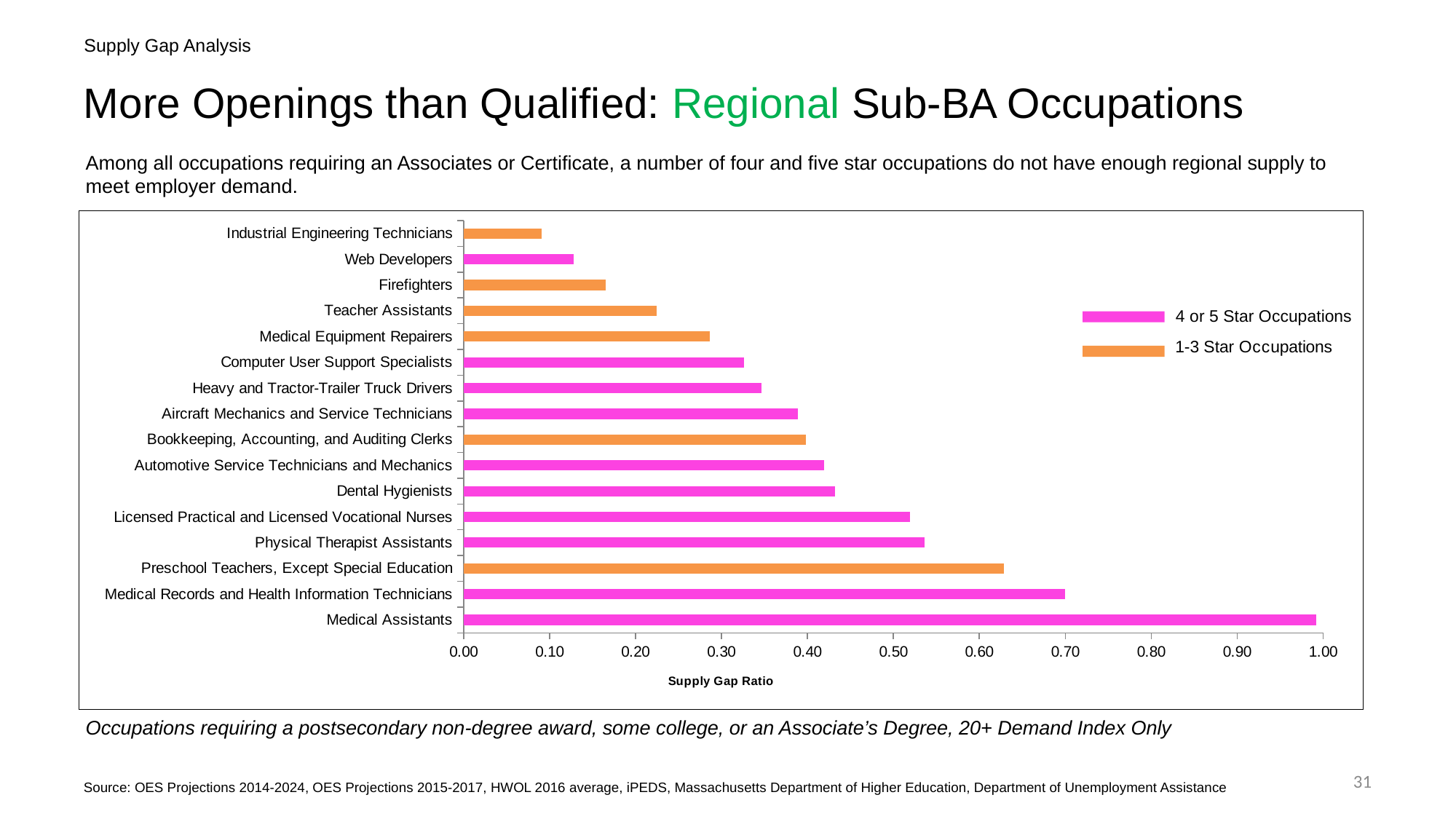
Which occupation has the highest supply gap ratio? Medical Assistants Is the supply gap ratio for Medical Assistants greater or less than 0.90? greater Is the supply gap ratio for Licensed Practical and Licensed Vocational Nurses greater or less than 0.50? greater How many occupations are plotted in the chart? 16 How many series does the legend list? 2 Which occupation has the lowest supply gap ratio? Industrial Engineering Technicians What kind of chart is shown on the slide? bar chart Which has a larger supply gap ratio, Web Developers or Firefighters? Firefighters What is the title of the x axis of the chart? Supply Gap Ratio Is the supply gap ratio for Firefighters greater or less than 0.20? less Which has a larger supply gap ratio, Preschool Teachers, Except Special Education or Physical Therapist Assistants? Preschool Teachers, Except Special Education